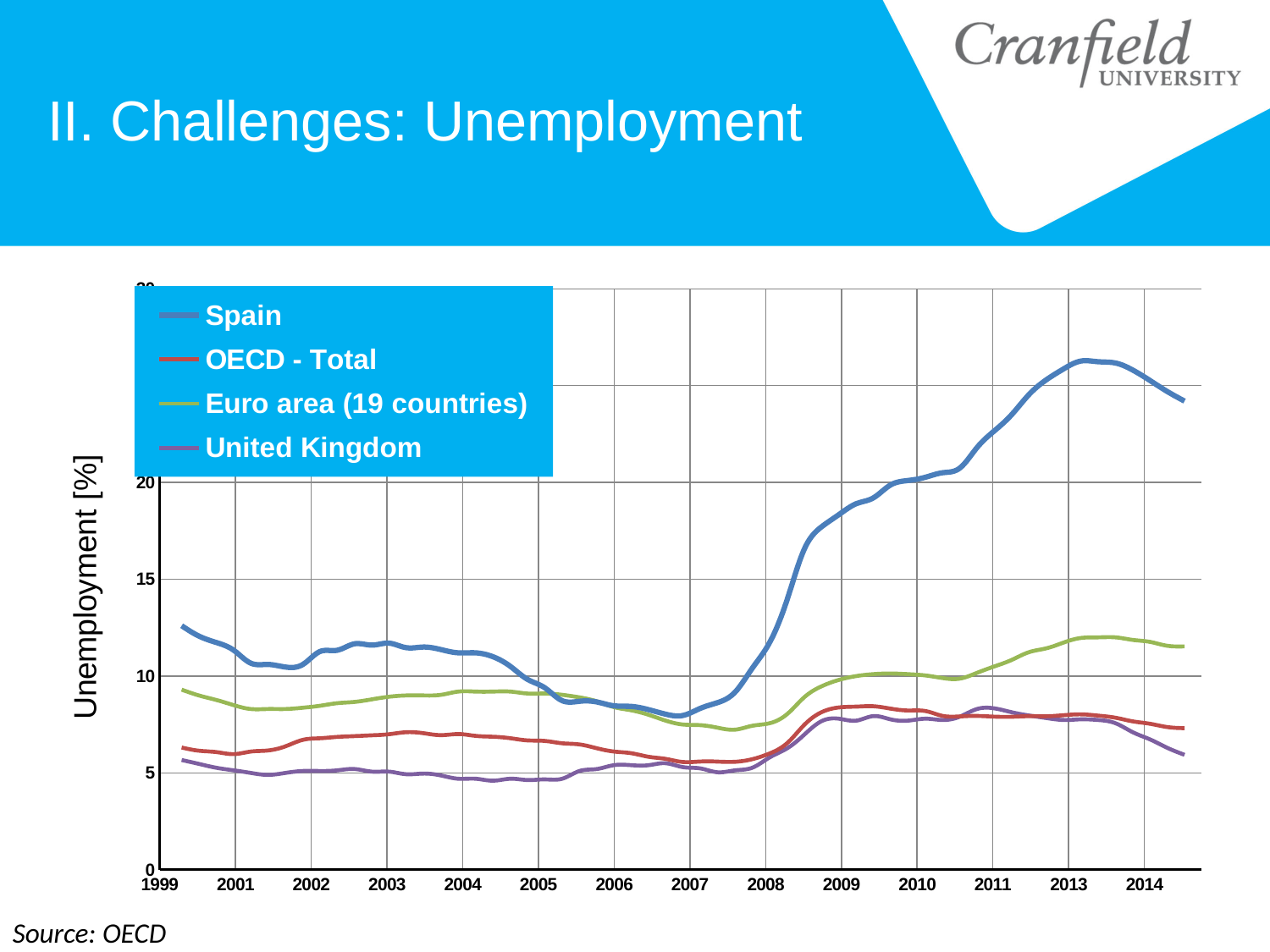
Which series reaches the highest unemployment value on the chart? Spain Is the value for Spain in 2013 greater or less than 20? greater What is the label on the vertical axis? Unemployment [%] What kind of chart is shown on the slide? line chart Does the Spain series rise or fall between 2008 and 2013? rise In 2013, which is larger: the value for Spain or the value for United Kingdom? Spain Is the value for Euro area (19 countries) in 2013 greater or less than 10? greater How many series does the legend list? 4 Is the value for Spain in 2007 greater or less than 10? less In 2013, which is larger: the value for Euro area (19 countries) or the value for OECD - Total? Euro area (19 countries) Which series has the lowest value at the right-hand end of the chart (2014)? United Kingdom